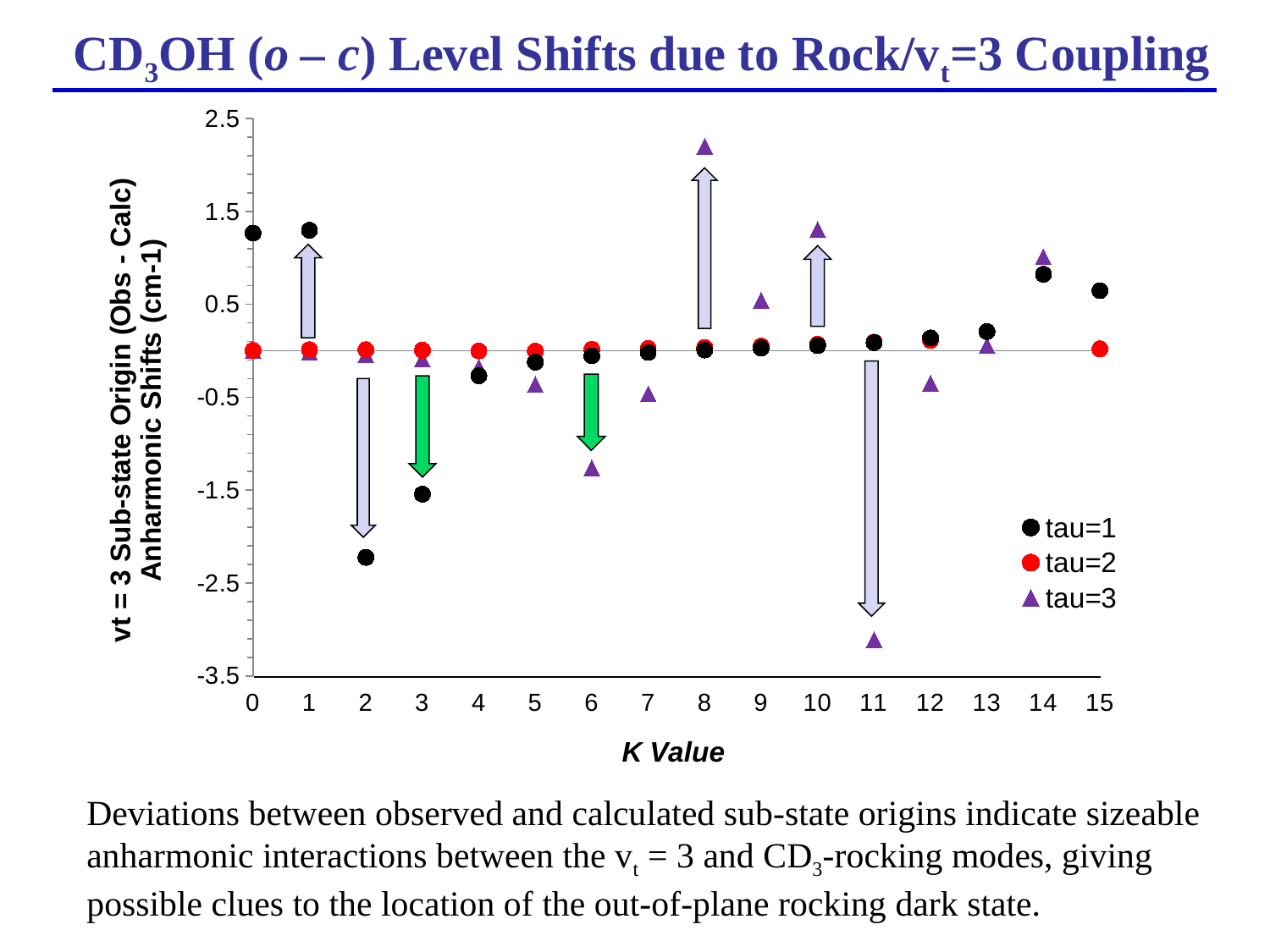
Which is larger for the tau=3 series: the value at K=8 or the value at K=10? K=8 At which K value does the tau=3 series reach its highest point? 8 Is the tau=3 value at K=8 greater or less than 1.5? greater What kind of chart is shown on the slide? scatter chart At which K value does the tau=1 series reach its lowest point? 2 What is the title of the x axis? K Value How many series does the legend list? 3 At which K value does the tau=3 series reach its lowest point? 11 What are the three series named in the legend? tau=1, tau=2, tau=3 Is the tau=1 value at K=2 greater or less than -1.5? less How many K values are plotted along the x axis? 16 Is the tau=3 value at K=11 greater or less than -2.5? less